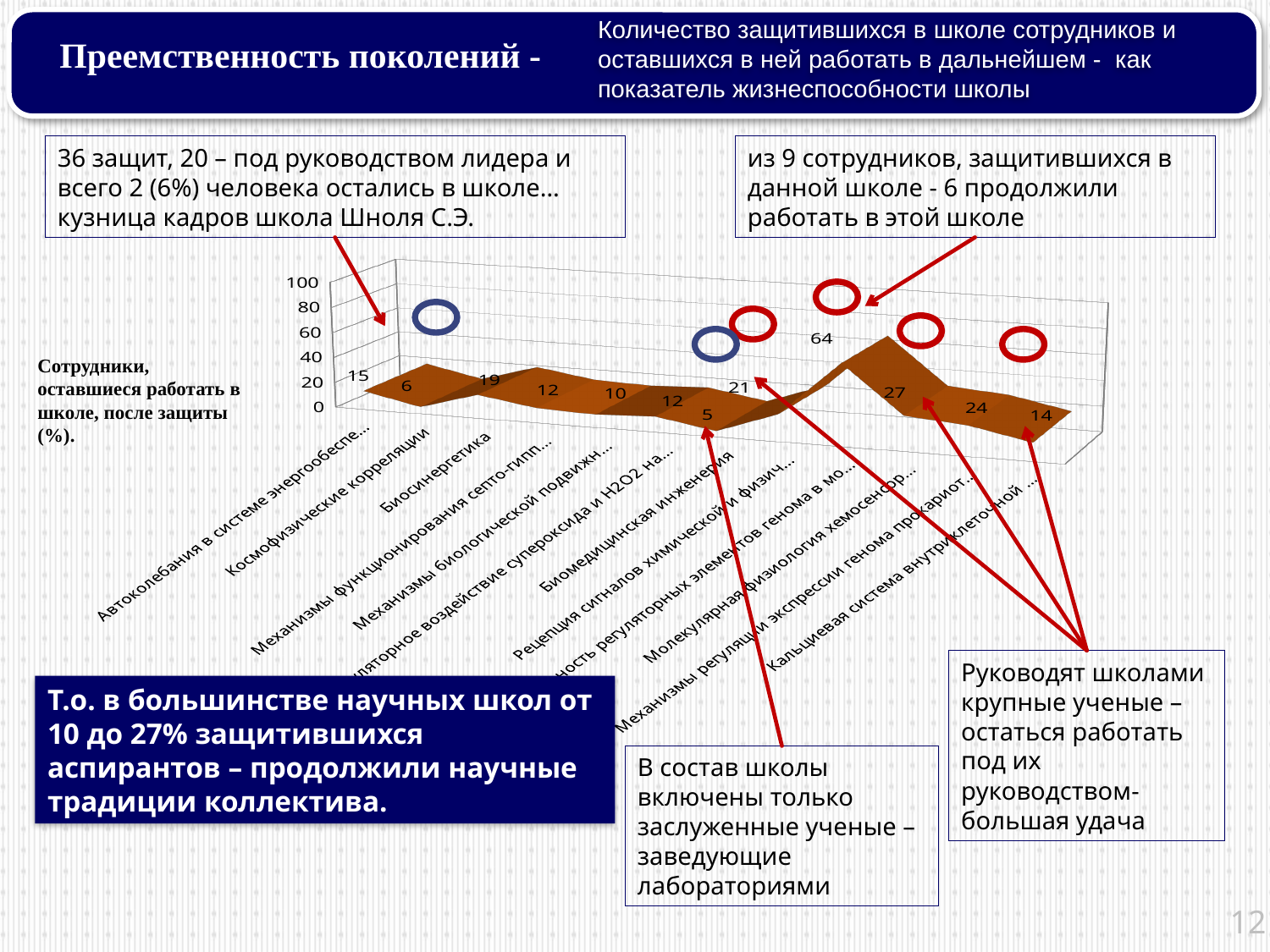
What type of chart is shown on the slide? 3D line chart What is the maximum value shown on the vertical axis of the chart? 100 What is the difference between the highest value (64) and the lowest value (5) on the chart? 59 What is the lowest data value shown on the chart? 5 What is the value for the first category on the x axis, 'Автоколебания в системе энергообеспе...'? 15 What is the highest data value shown on the chart? 64 What is the value for the category 'Космофизические корреляции'? 6 According to the text next to the chart, what does the vertical axis represent? Сотрудники, оставшиеся работать в школе, после защиты (%) How many categories (scientific schools) are plotted along the x axis of the chart? 12